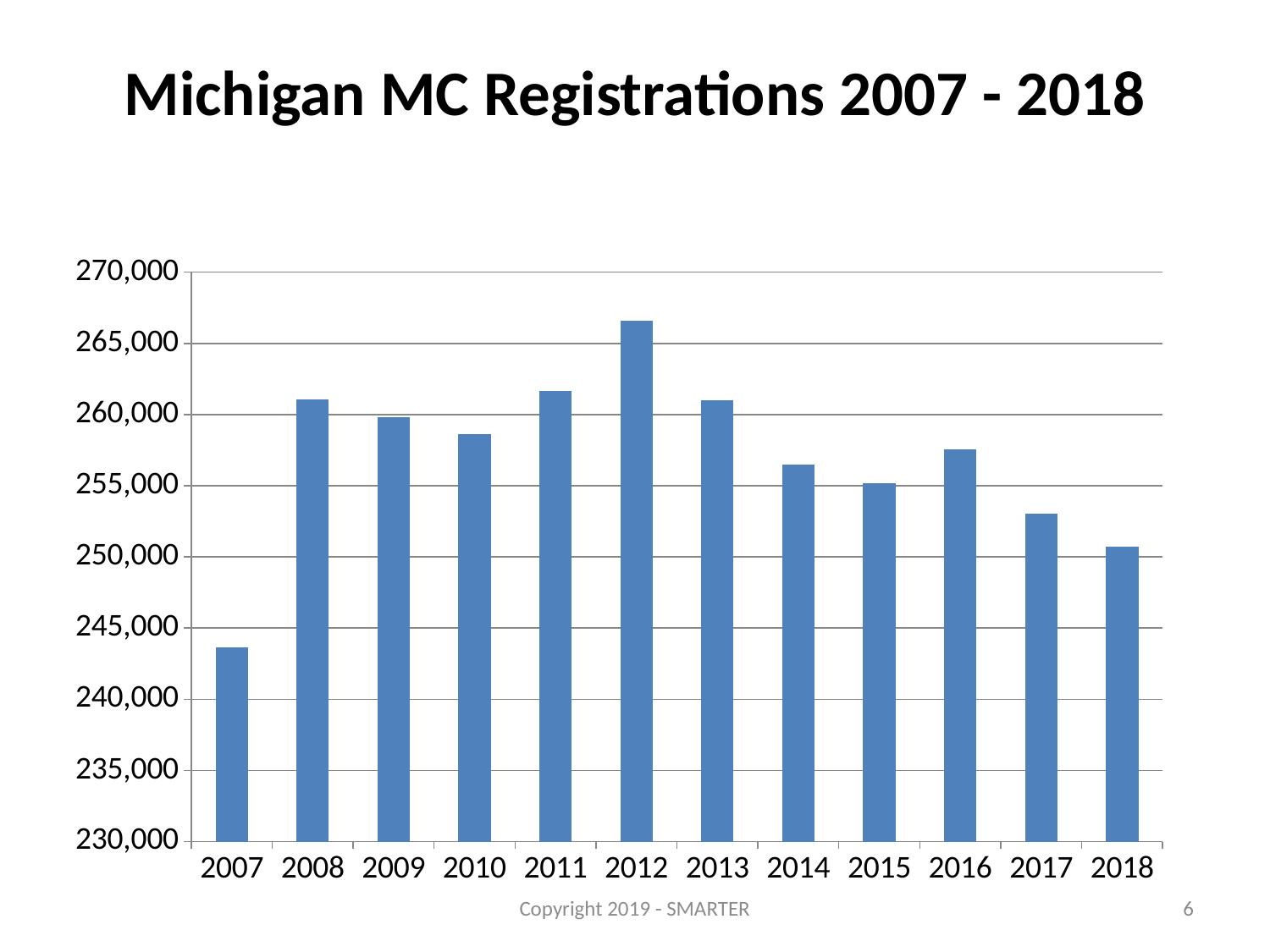
Is the value for 2017 greater or less than 255,000? less What kind of chart is shown on the slide? Bar chart Which year has more registrations, 2012 or 2011? 2012 Which year has the highest number of Michigan MC registrations? 2012 Is the value for 2012 greater or less than 265,000? greater Do the registration values rise or fall from 2013 to 2015? fall Is the value for 2007 greater or less than 245,000? less Which year has the lowest number of Michigan MC registrations? 2007 How many years are plotted on the chart? 12 Which year has more registrations, 2017 or 2018? 2017